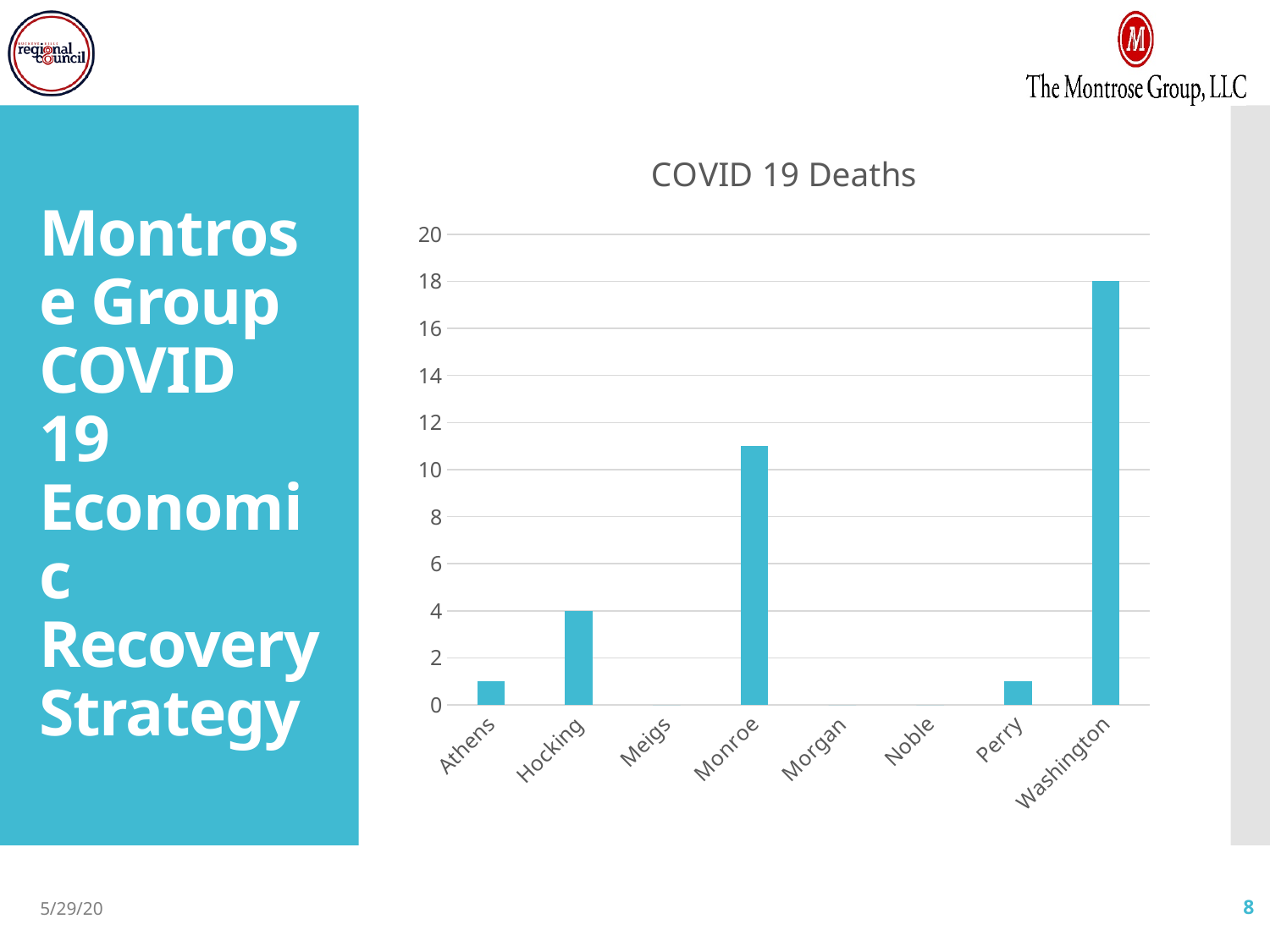
What kind of chart is shown on the slide? bar chart How many COVID 19 deaths are shown for Hocking? 4 How many counties are shown on the x axis of the chart? 8 What is the title of the chart? COVID 19 Deaths Which county has the highest number of COVID 19 deaths? Washington What is the highest value shown on the y axis of the chart? 20 Is the value for Monroe greater or less than 10? greater Which has more COVID 19 deaths, Washington or Monroe? Washington Is the value for Athens greater or less than 2? less Which has more COVID 19 deaths, Monroe or Hocking? Monroe How many COVID 19 deaths are shown for Washington? 18 What is the difference between the COVID 19 deaths for Washington and Hocking? 14